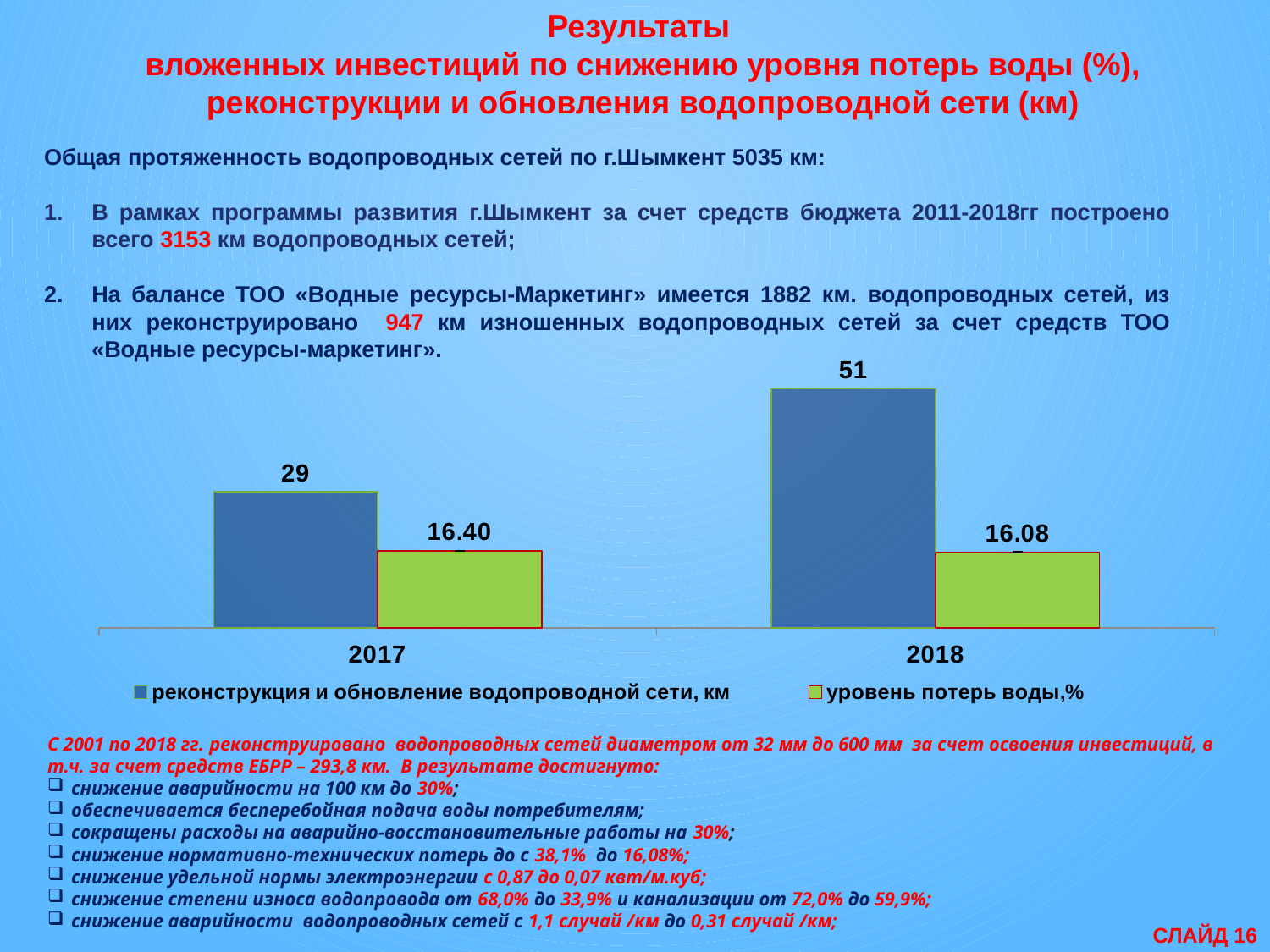
What is the value for 'уровень потерь воды,%' in 2017? 16.40 What is the difference between the 2018 and 2017 values for 'реконструкция и обновление водопроводной сети, км'? 22 Which year has the higher value for 'реконструкция и обновление водопроводной сети, км'? 2018 How many categories (years) are shown on the x axis? 2 Which is larger: the 2017 value for 'реконструкция и обновление водопроводной сети, км' or the 2017 value for 'уровень потерь воды,%'? реконструкция и обновление водопроводной сети, км What is the value for 'реконструкция и обновление водопроводной сети, км' in 2017? 29 What is the difference between the 2017 and 2018 values for 'уровень потерь воды,%'? 0.32 Does the value for 'реконструкция и обновление водопроводной сети, км' rise or fall from 2017 to 2018? rise What kind of chart is shown on the slide? bar chart What is the value for 'уровень потерь воды,%' in 2018? 16.08 How many series does the legend list? 2 What is the value for 'реконструкция и обновление водопроводной сети, км' in 2018? 51